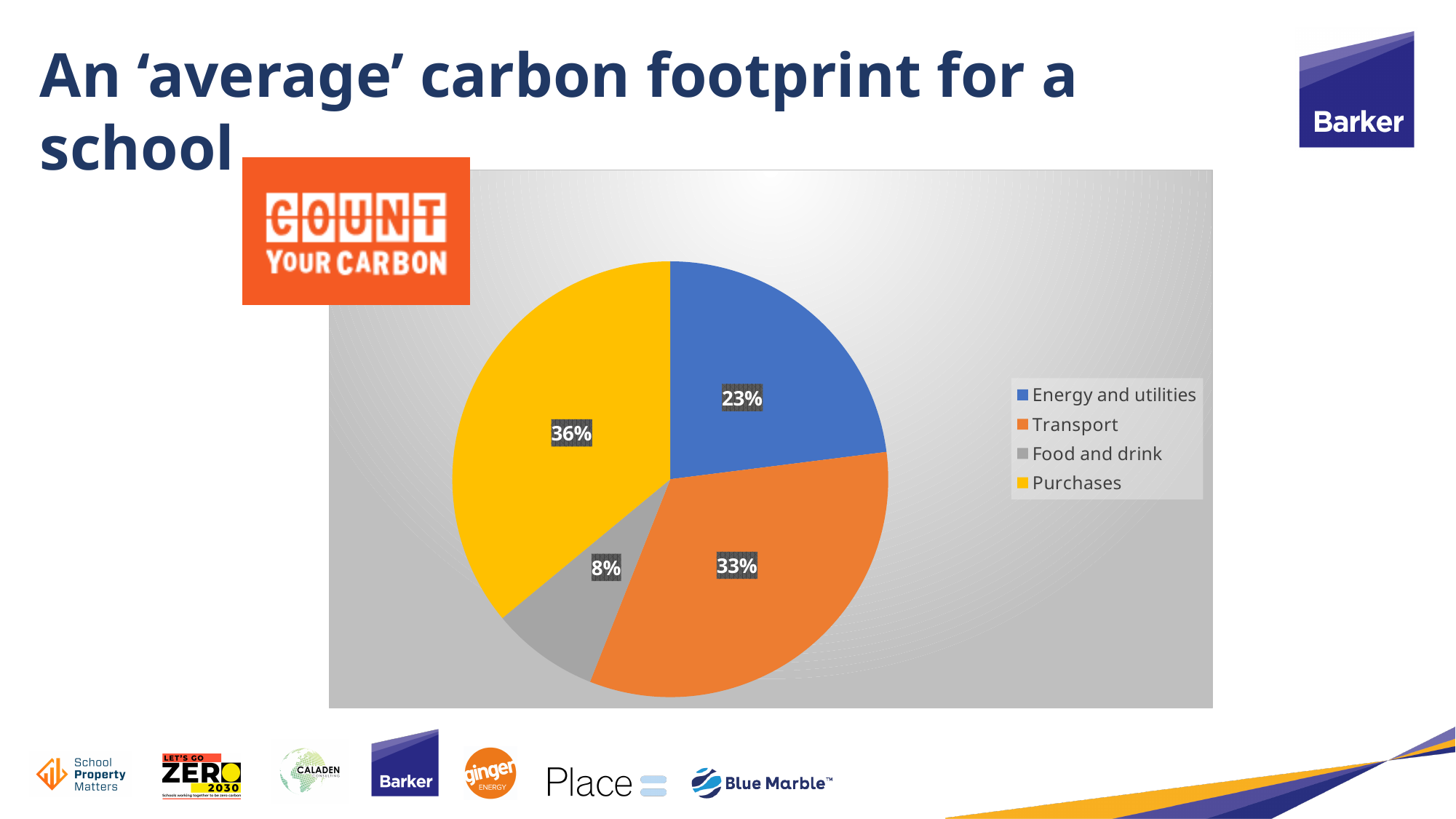
Which category has the smallest share of the pie? Food and drink Which is larger, Transport or Energy and utilities? Transport What share of the carbon footprint is Transport? 33% How many categories does the pie chart have? 4 What share of the carbon footprint is Energy and utilities? 23% Which category is shown in yellow? Purchases What share of the carbon footprint is Food and drink? 8% What kind of chart is shown on the slide? Pie chart What share of the carbon footprint is Purchases? 36% What colour is the Transport slice? Orange Which category has the largest share of the pie? Purchases What is the difference in percentage points between Purchases and Energy and utilities? 13